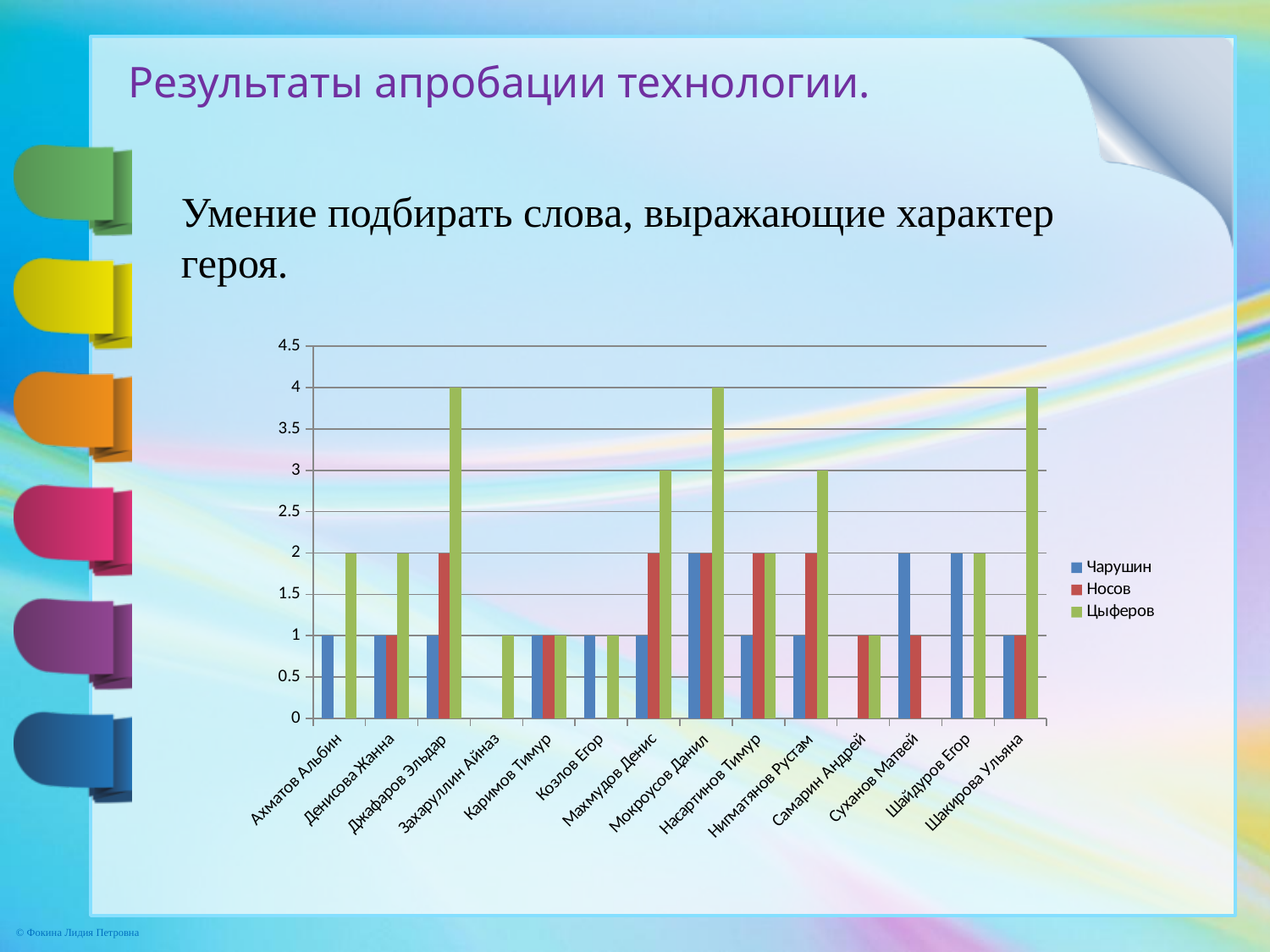
What is the value for Чарушин for Мокроусов Данил? 2 What is the value for Цыферов for Нигматянов Рустам? 3 What is the value for Носов for Махмудов Денис? 2 What kind of chart is shown on the slide? bar chart Is the Цыферов value for Мокроусов Данил greater or less than 3? greater What is the difference between the Цыферов and Чарушин values for Шакирова Ульяна? 3 What is the value for Цыферов for Джафаров Эльдар? 4 How many series does the legend list? 3 For Суханов Матвей, which is larger: the Чарушин value or the Носов value? Чарушин Which series is shown in green in the legend? Цыферов How many students (categories) are shown on the x axis? 14 For Джафаров Эльдар, which is larger: the Носов value or the Цыферов value? Цыферов